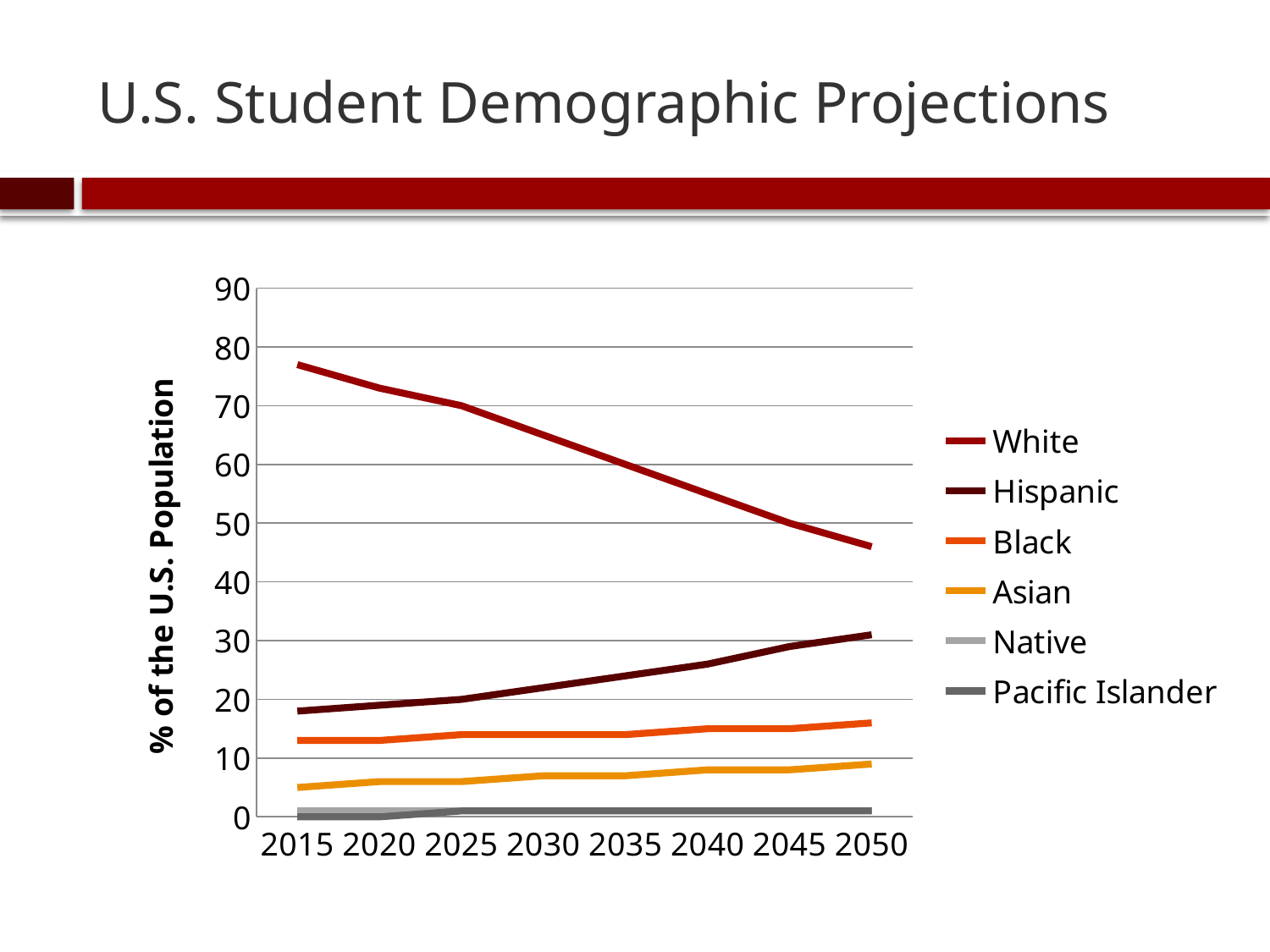
Is the value for Black in 2050 greater or less than 10? greater Does the Hispanic series rise or fall from 2015 to 2050? rise How many series does the legend list? 6 Which series has the highest value in 2015? White How many years are shown along the x axis? 8 What is the label on the y axis? % of the U.S. Population Is the value for Hispanic in 2015 greater or less than 20? less Is the value for White in 2050 greater or less than 50? less Does the White series rise or fall from 2015 to 2050? fall What kind of chart is shown on the slide? line chart In 2050, which is larger, the value for White or the value for Hispanic? White